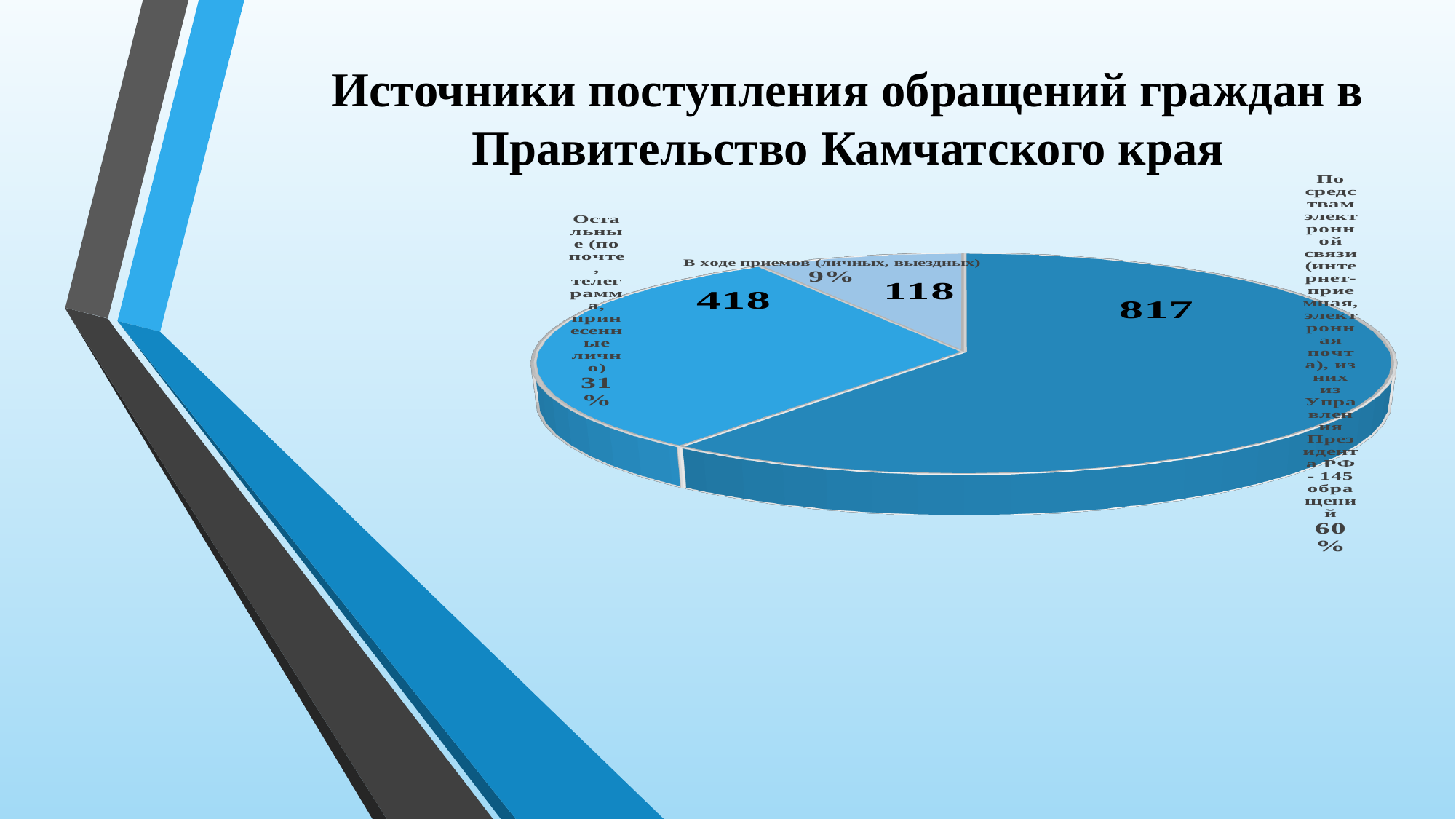
What is the difference between the value for 'По средствам электронной связи' and the value for 'Остальные (по почте, телеграмма, принесенные лично)'? 399 What is the title of the chart on the slide? Источники поступления обращений граждан в Правительство Камчатского края What is the value for the slice 'Остальные (по почте, телеграмма, принесенные лично)'? 418 What kind of chart is shown on the slide? Pie chart What is the value for the slice 'В ходе приемов (личных, выездных)'? 118 How many slices does the pie chart have? 3 Which slice of the pie chart is the smallest? В ходе приемов (личных, выездных) What is the value for the slice 'По средствам электронной связи'? 817 What percentage share is shown for the slice 'В ходе приемов (личных, выездных)'? 9% What percentage share is shown for the slice 'Остальные (по почте, телеграмма, принесенные лично)'? 31% Which slice of the pie chart is the largest? По средствам электронной связи What percentage share is shown for the slice 'По средствам электронной связи'? 60%